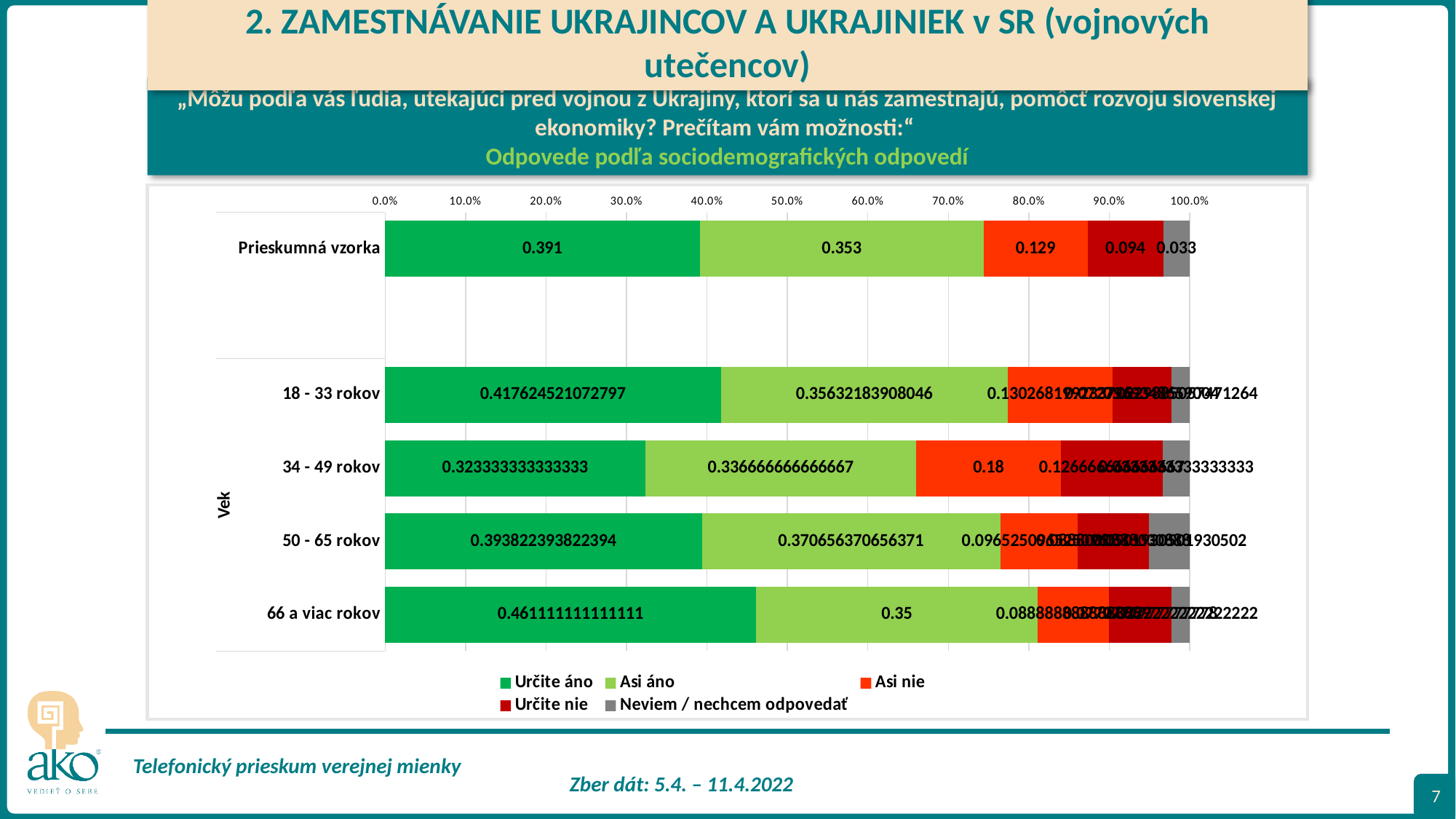
Which age group has the lowest value for 'Určite áno'? 34 - 49 rokov For 'Prieskumná vzorka', what is the difference between 'Určite áno' and 'Asi áno'? 0.038 How many categories (bars) are plotted on the chart? 5 What is the value of 'Asi nie' for 'Prieskumná vzorka'? 0.129 Which age group has the highest value for 'Určite áno'? 66 a viac rokov How many series does the legend list? 5 What is the value of 'Asi nie' for '34 - 49 rokov'? 0.18 What is the value of 'Určite áno' for 'Prieskumná vzorka'? 0.391 Is the value of 'Asi nie' for '18 - 33 rokov' greater or less than 20%? less What is the value of 'Neviem / nechcem odpovedať' for 'Prieskumná vzorka'? 0.033 What is the value of 'Asi áno' for '66 a viac rokov'? 0.35 What kind of chart is shown on the slide? stacked bar chart